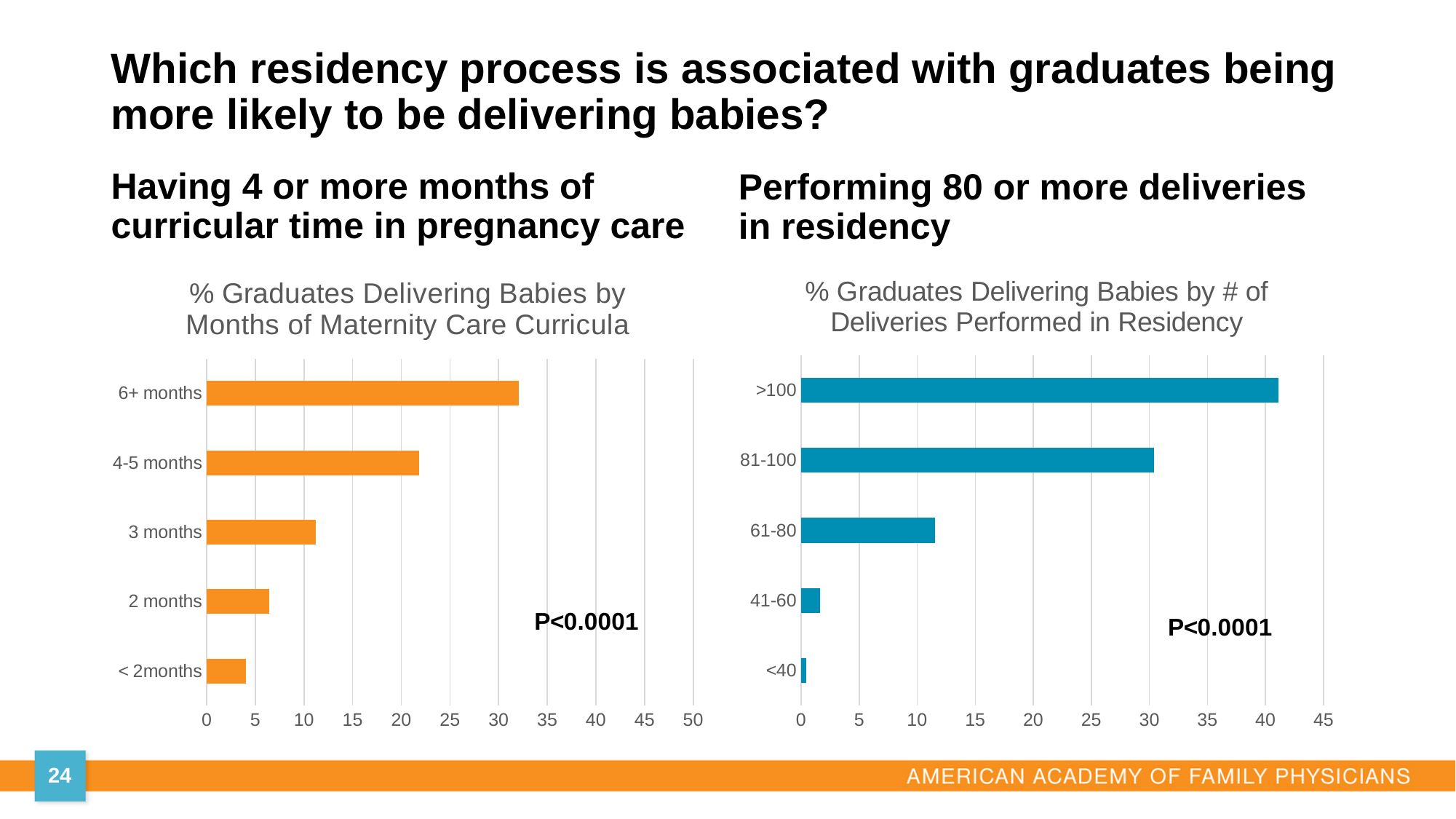
In the right chart, '% Graduates Delivering Babies by # of Deliveries Performed in Residency', is the value for >100 greater or less than 40? greater In the right chart, '% Graduates Delivering Babies by # of Deliveries Performed in Residency', which category has the highest value? >100 In the left chart, '% Graduates Delivering Babies by Months of Maternity Care Curricula', which category has the highest value? 6+ months In the left chart, '% Graduates Delivering Babies by Months of Maternity Care Curricula', which category has the lowest value? < 2months In the left chart, '% Graduates Delivering Babies by Months of Maternity Care Curricula', is the value for 3 months greater or less than 15? less In the left chart, '% Graduates Delivering Babies by Months of Maternity Care Curricula', how many categories are shown? 5 In the left chart, '% Graduates Delivering Babies by Months of Maternity Care Curricula', is the value for 6+ months greater or less than 30? greater What is the highest value shown on the horizontal axis of the left chart, '% Graduates Delivering Babies by Months of Maternity Care Curricula'? 50 In the left chart, '% Graduates Delivering Babies by Months of Maternity Care Curricula', which is larger: the value for 4-5 months or the value for 2 months? 4-5 months What type of chart is the right chart, '% Graduates Delivering Babies by # of Deliveries Performed in Residency'? Bar chart In the right chart, '% Graduates Delivering Babies by # of Deliveries Performed in Residency', which category has the lowest value? <40